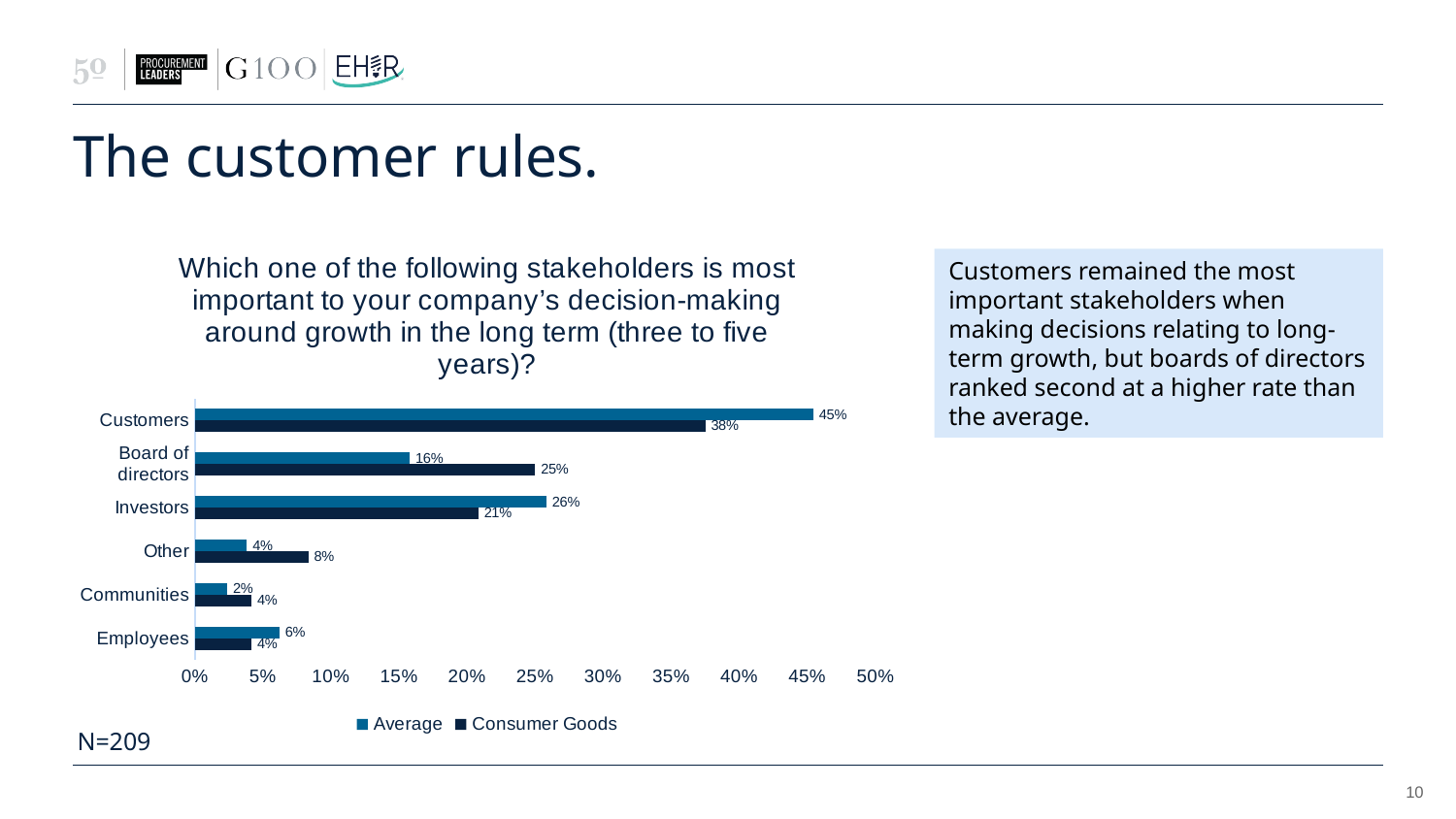
What is the Consumer Goods value for Investors? 21% For Board of directors, which is larger: the Average value or the Consumer Goods value? Consumer Goods How many stakeholder categories are shown in the chart? 6 Which stakeholder has the highest Consumer Goods value? Customers How many series does the legend list? 2 Which stakeholder has the lowest Average value? Communities What is the Consumer Goods value for Board of directors? 25% What is the Average value for Employees? 6% What type of chart is shown on the slide? Bar chart What is the Average value for Customers? 45% What is the sample size (N) stated on the slide? N=209 What is the difference between the Average and Consumer Goods values for Customers? 7%